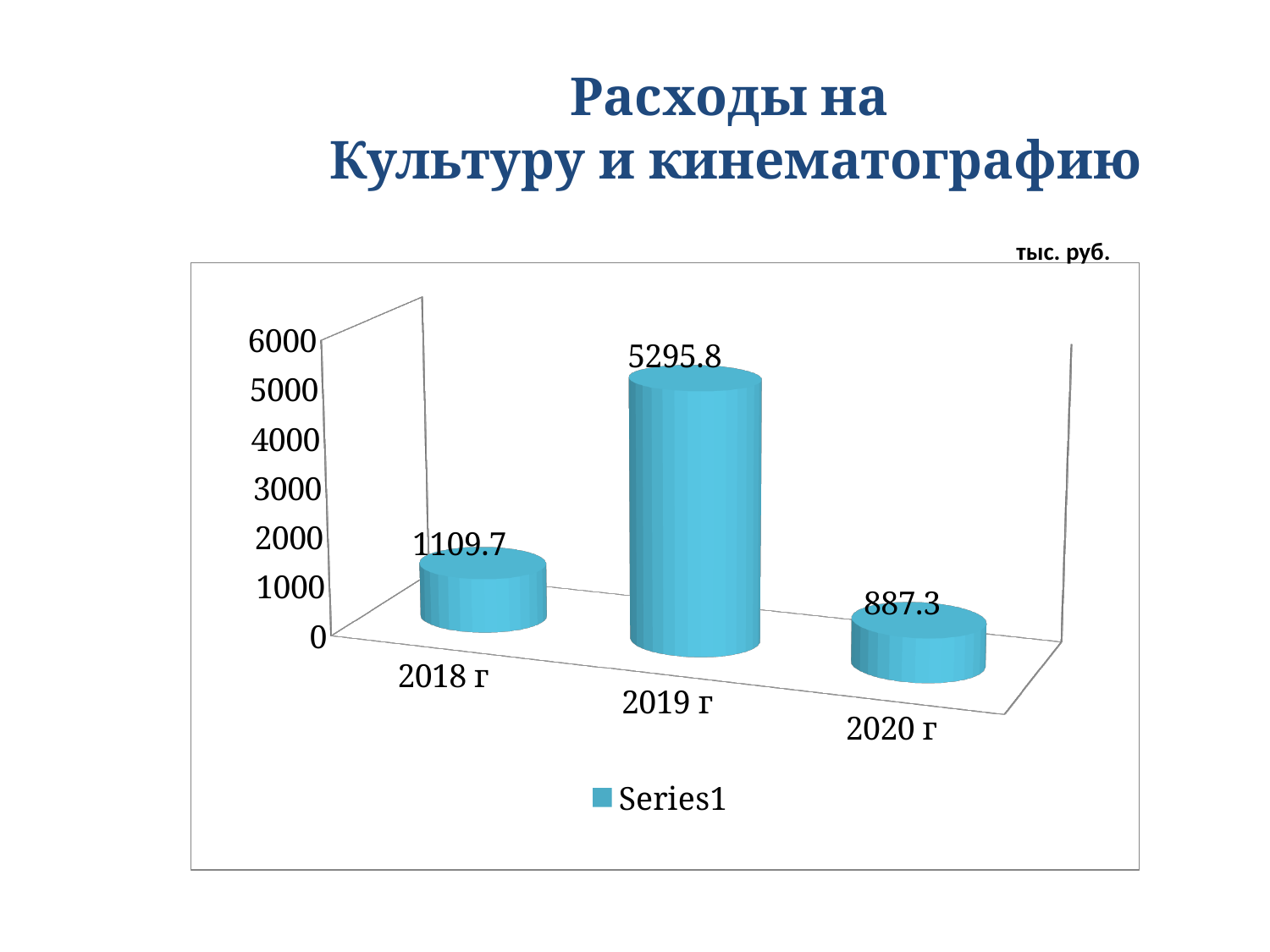
What is the value for 2018 г? 1109.7 Which year has the highest value? 2019 г What kind of chart is shown on the slide? bar chart Which is larger, the value for 2018 г or the value for 2020 г? 2018 г Is the value for 2019 г greater or less than 5000? greater What unit is indicated above the chart? тыс. руб. Which year has the lowest value? 2020 г What is the difference between the values for 2019 г and 2018 г? 4186.1 What is the difference between the values for 2018 г and 2020 г? 222.4 What is the value for 2019 г? 5295.8 How many categories are shown on the x axis? 3 What is the value for 2020 г? 887.3